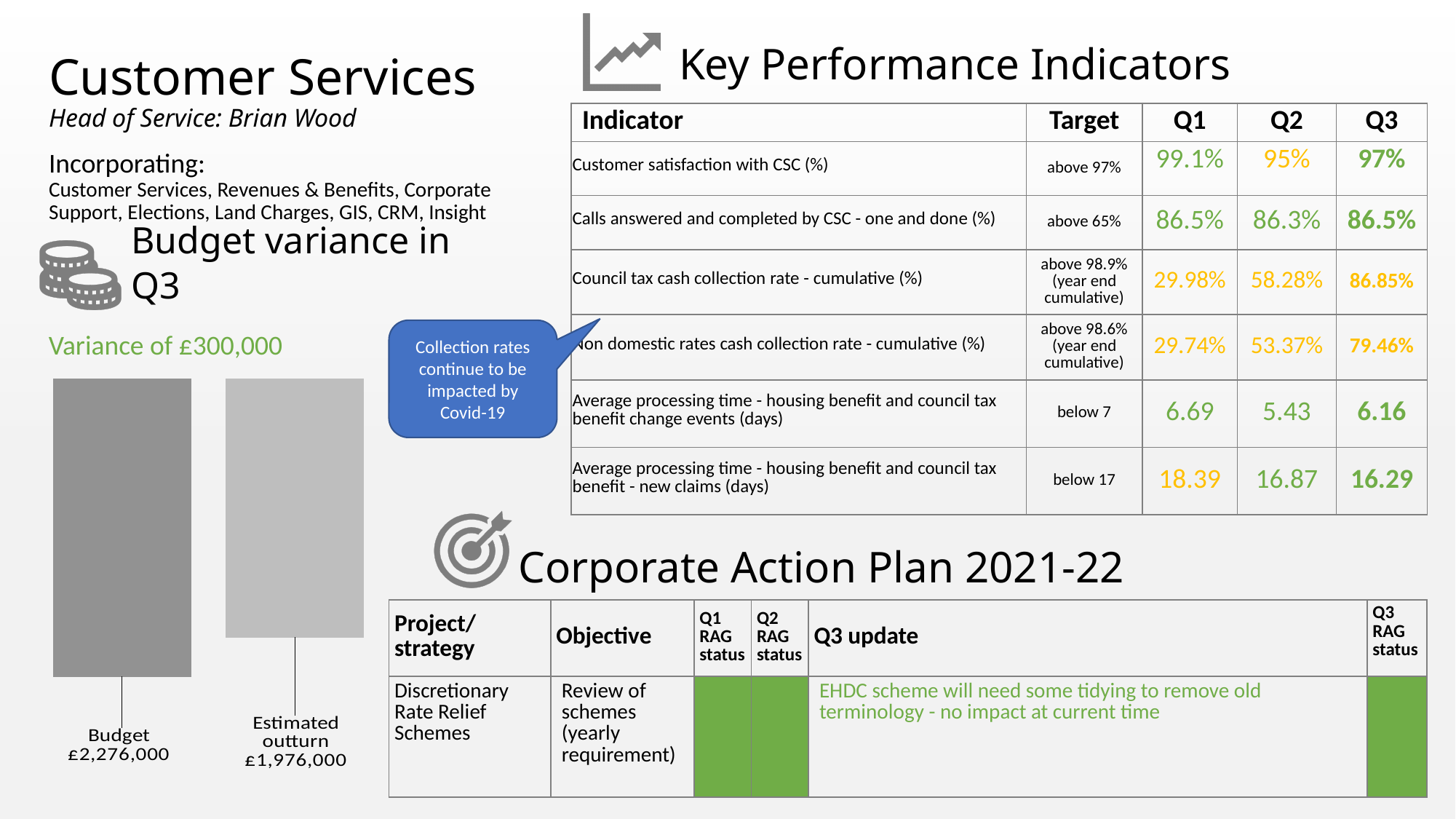
In the 'Budget variance in Q3' chart, what is the value of the Estimated outturn bar? £1,976,000 In the 'Budget variance in Q3' chart, what is the value of the Budget bar? £2,276,000 How many bars are plotted in the 'Budget variance in Q3' chart? 2 In the 'Budget variance in Q3' chart, which bar is the lowest? Estimated outturn What kind of chart is shown under the 'Budget variance in Q3' heading? bar chart In the 'Budget variance in Q3' chart, what is the difference between the Budget and the Estimated outturn? £300,000 In the 'Budget variance in Q3' chart, which bar is the highest? Budget In the 'Budget variance in Q3' chart, which bar is drawn in the darker grey? Budget In the 'Budget variance in Q3' chart, which is larger: Budget or Estimated outturn? Budget What is the title of the chart on the left of the slide? Budget variance in Q3